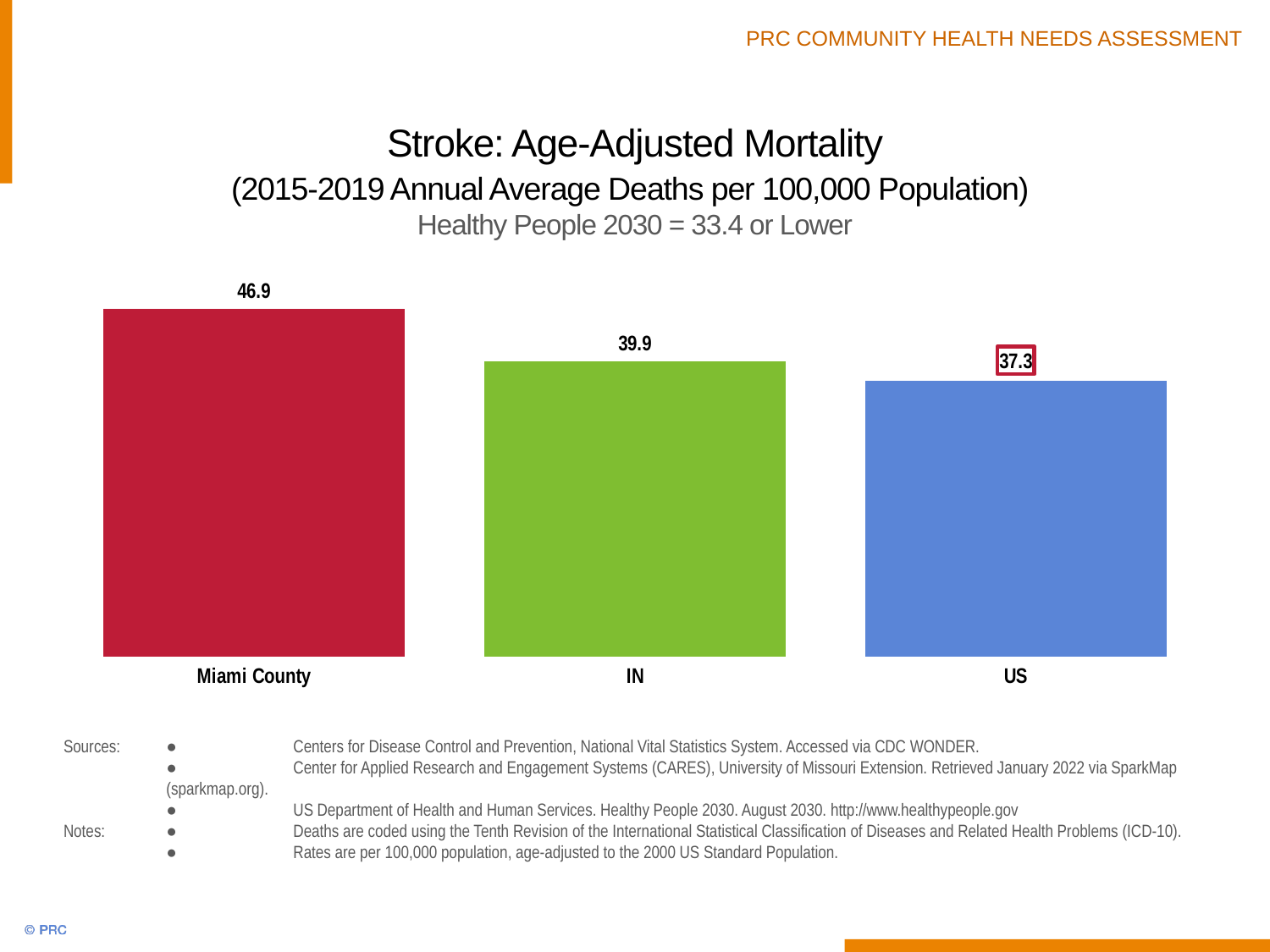
What is the stroke age-adjusted mortality rate for Miami County? 46.9 Which is larger, the rate for Miami County or the rate for the US? Miami County What colour is the bar for IN? Green What is the Healthy People 2030 target stated on the slide? 33.4 or Lower What kind of chart is shown on the slide? Bar chart What is the stroke age-adjusted mortality rate for IN? 39.9 What is the stroke age-adjusted mortality rate for the US? 37.3 Which category has the lowest stroke age-adjusted mortality rate? US What is the difference between the IN rate and the US rate? 2.6 Which category has the highest stroke age-adjusted mortality rate? Miami County What is the difference between the Miami County rate and the IN rate? 7.0 How many categories are shown in the chart? 3